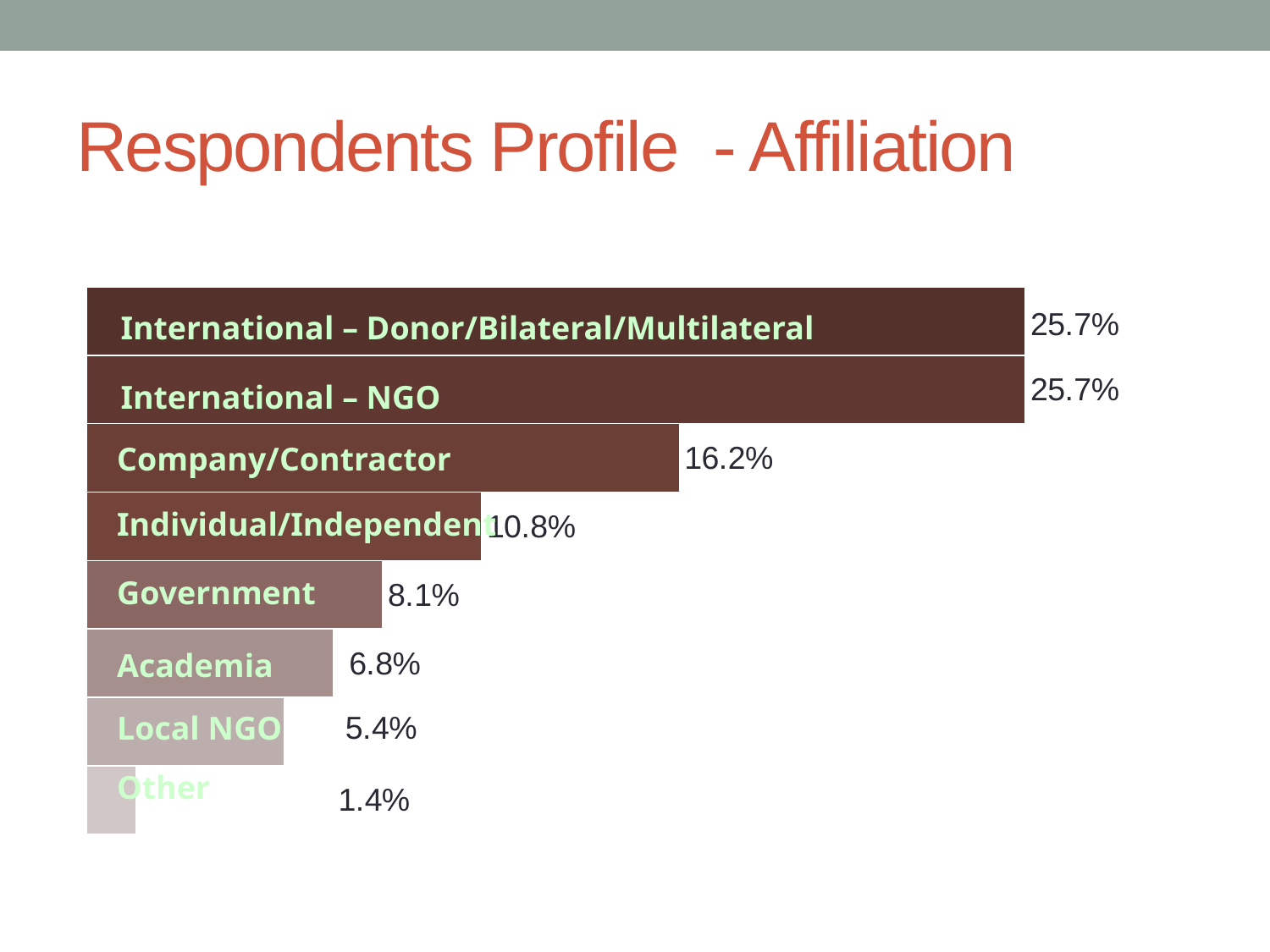
How many affiliation categories are shown in the chart? 8 What is the value for Individual/Independent? 10.8% What kind of chart is shown on the slide? Bar chart What is the difference between the Company/Contractor value and the Academia value? 9.4% What is the title of the slide? Respondents Profile - Affiliation What is the difference between the International – NGO value and the Government value? 17.6% Which is larger, the value for Academia or the value for Local NGO? Academia Which is larger, the value for Individual/Independent or the value for Company/Contractor? Company/Contractor What percentage is shown for Local NGO? 5.4% Which affiliation category has the lowest value? Other What percentage of respondents are affiliated with Company/Contractor? 16.2% What is the value shown for Government? 8.1%